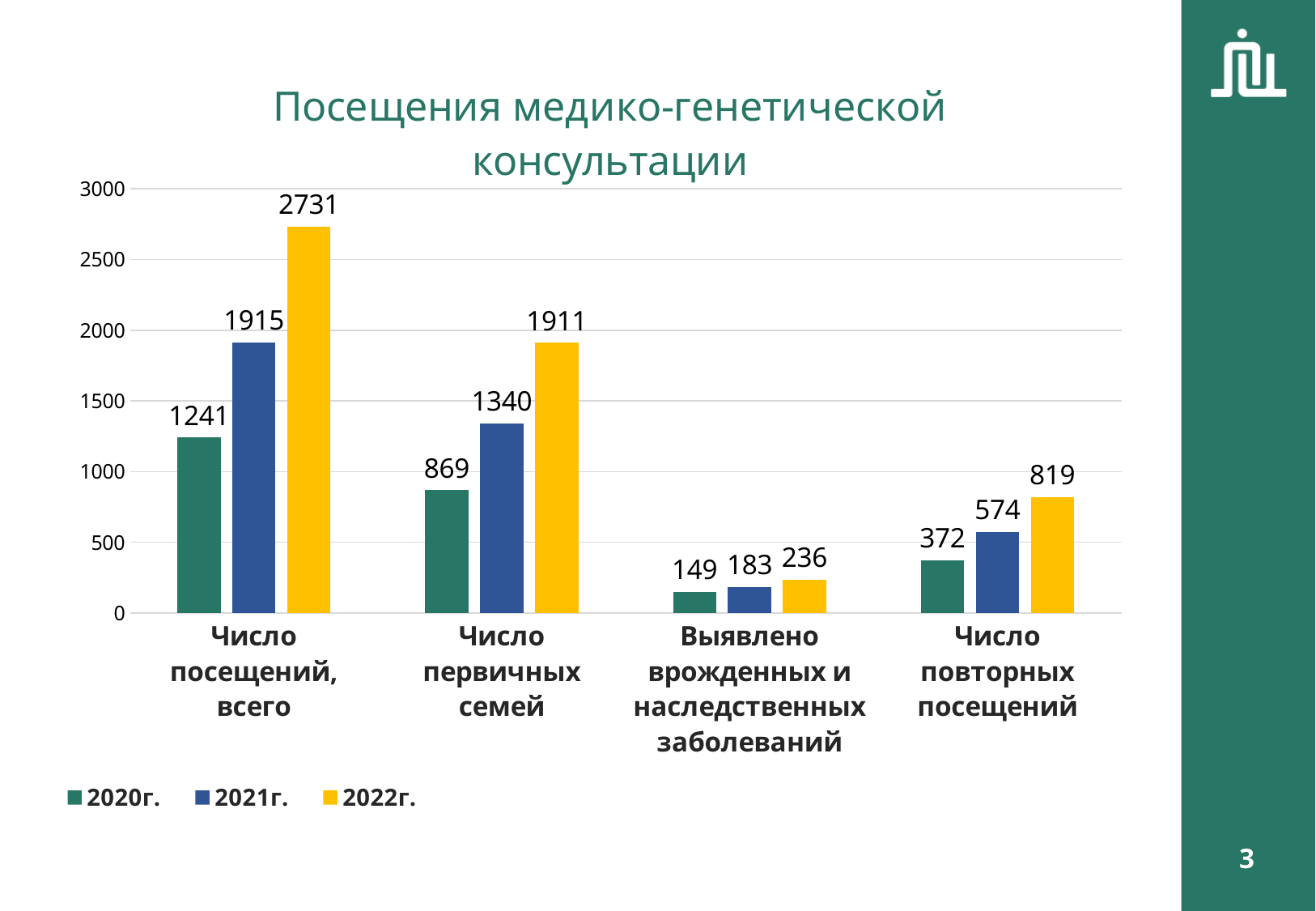
What is the value for 2020г. in the category "Число первичных семей"? 869 Is the 2022г. value for "Число повторных посещений" greater or less than 1000? less Which category has the lowest value for 2020г.? Выявлено врожденных и наследственных заболеваний Do the values for "Число первичных семей" rise or fall from 2020г. to 2022г.? rise What kind of chart is shown on the slide? bar chart How many categories are shown on the x axis? 4 What is the value for 2022г. in the category "Число посещений, всего"? 2731 How many series does the legend list? 3 Which is larger: the 2021г. value for "Число первичных семей" or the 2020г. value for "Число посещений, всего"? 2021г. value for "Число первичных семей" Which year has the highest value in the category "Выявлено врожденных и наследственных заболеваний"? 2022г. What is the difference between the 2022г. and 2020г. values in the category "Число посещений, всего"? 1490 What is the value for 2021г. in the category "Число повторных посещений"? 574